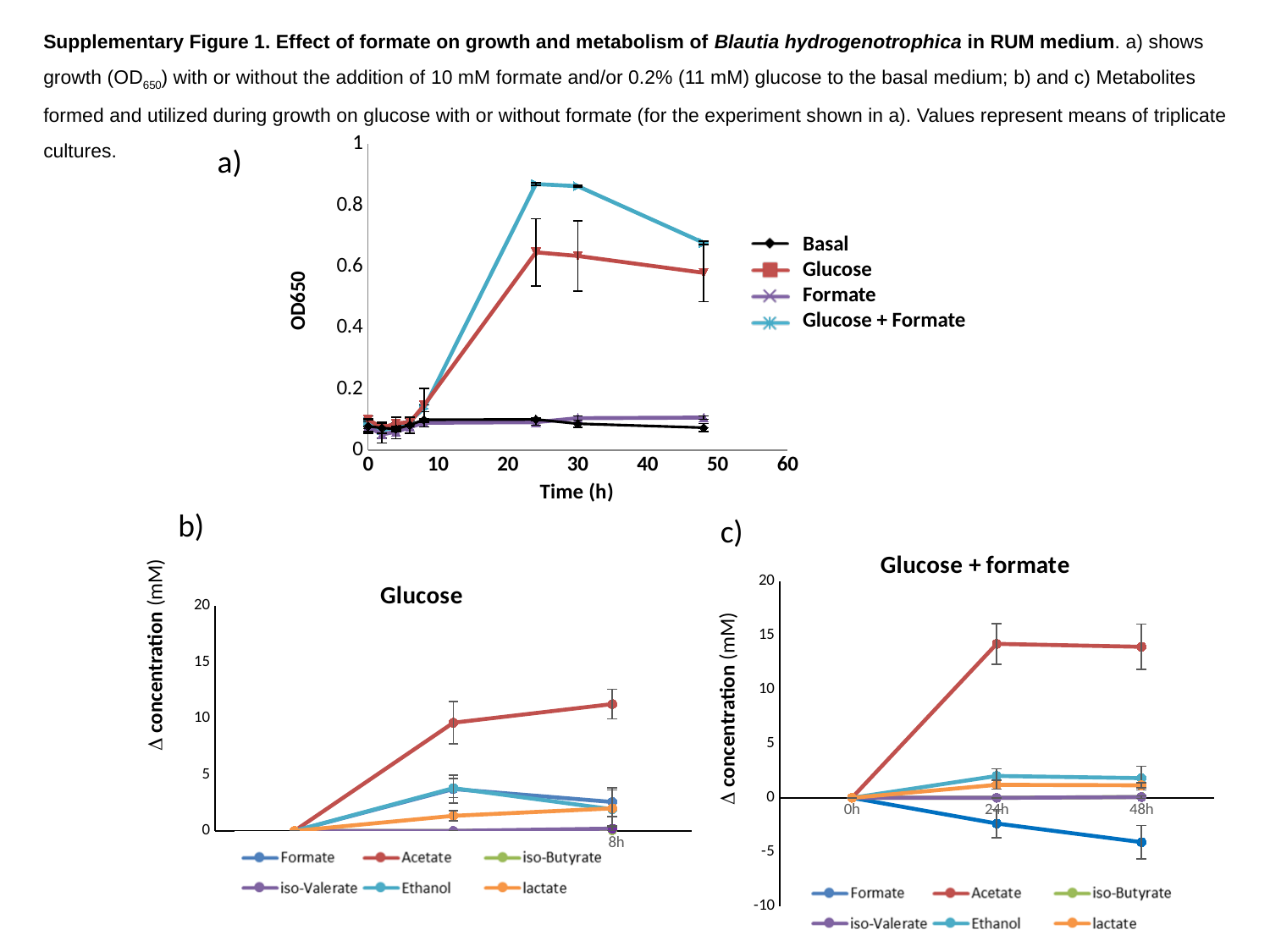
In chart a) (the OD650 chart), is the value for Basal at 48 h greater or less than 0.2? less In chart b) (Glucose), is the final value for Acetate greater or less than 10? greater In chart a) (the OD650 chart), does the Glucose + Formate series rise or fall between 24 h and 48 h? fall How many series does the legend of chart a) (the OD650 chart) list? 4 In chart c) (Glucose + formate), how many time points are plotted on the x axis? 3 In chart c) (Glucose + formate), which series has the lowest value at 48h? Formate What kind of chart is chart a) (the OD650 chart)? line chart How many series does the legend of chart b) (Glucose) list? 6 In chart a) (the OD650 chart), which series has the highest value at 24 h? Glucose + Formate In chart a) (the OD650 chart), is the value for Glucose + Formate at 24 h greater or less than 0.8? greater In chart a) (the OD650 chart), which is larger at 30 h: Glucose or Formate? Glucose In chart b) (Glucose), which metabolite reaches the highest concentration? Acetate